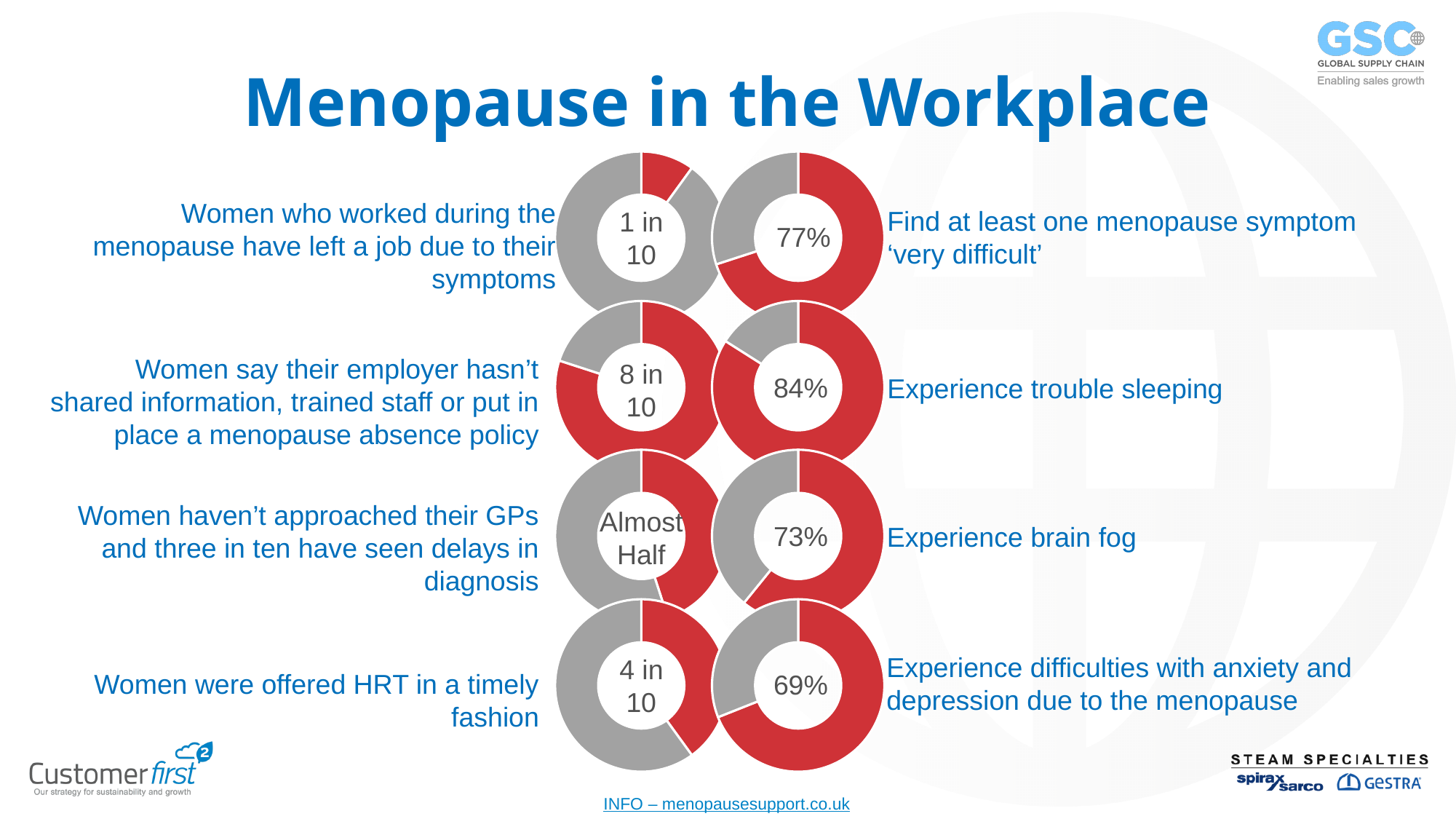
What value is shown in the donut chart for women who worked during the menopause and have left a job due to their symptoms? 1 in 10 What percentage of women find at least one menopause symptom 'very difficult'? 77% What percentage of women experience trouble sleeping, according to the donut chart next to that statement? 84% Among the four percentage donut charts in the right-hand column, which statement has the highest value? Experience trouble sleeping How many donut charts are shown on the slide? 8 What type of chart is used to display the statistics on this slide? Donut (pie) chart What value is shown in the donut chart for women who were offered HRT in a timely fashion? 4 in 10 What value is shown in the donut chart for women who experience difficulties with anxiety and depression due to the menopause? 69% Among the four percentage donut charts in the right-hand column, which statement has the lowest value? Experience difficulties with anxiety and depression due to the menopause What value is shown in the donut chart for women who say their employer hasn't shared information, trained staff or put in place a menopause absence policy? 8 in 10 What value is shown in the centre of the donut chart for women who experience brain fog? 73% What is the difference in percentage points between the trouble sleeping chart (84%) and the anxiety and depression chart (69%)? 15